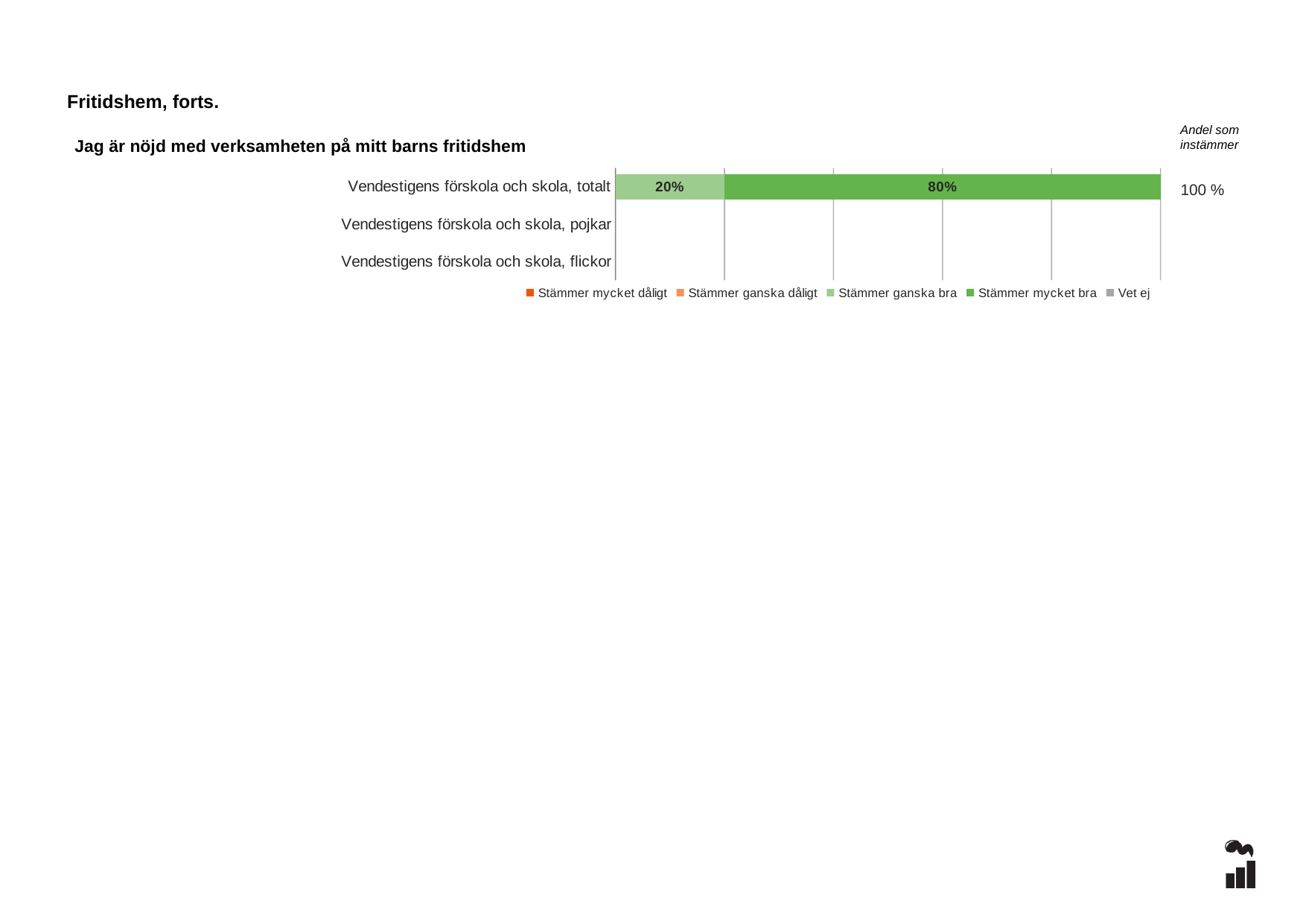
What is the total of the stacked bar for Vendestigens förskola och skola, totalt? 100% What kind of chart is shown on the slide? bar chart What is the "Andel som instämmer" value shown for Vendestigens förskola och skola, totalt? 100 % What is the value for "Stämmer ganska bra" for Vendestigens förskola och skola, totalt? 20% How many series does the legend list? 5 What is the value for "Stämmer mycket bra" for Vendestigens förskola och skola, totalt? 80% Which legend entry is shown in dark green? Stämmer mycket bra For Vendestigens förskola och skola, totalt, which is larger: "Stämmer mycket bra" or "Stämmer ganska bra"? Stämmer mycket bra What is the difference between the "Stämmer mycket bra" and "Stämmer ganska bra" values for Vendestigens förskola och skola, totalt? 60% Which category has the largest "Stämmer mycket bra" segment? Vendestigens förskola och skola, totalt What is the title of the chart? Jag är nöjd med verksamheten på mitt barns fritidshem How many categories are listed on the vertical axis of the chart? 3